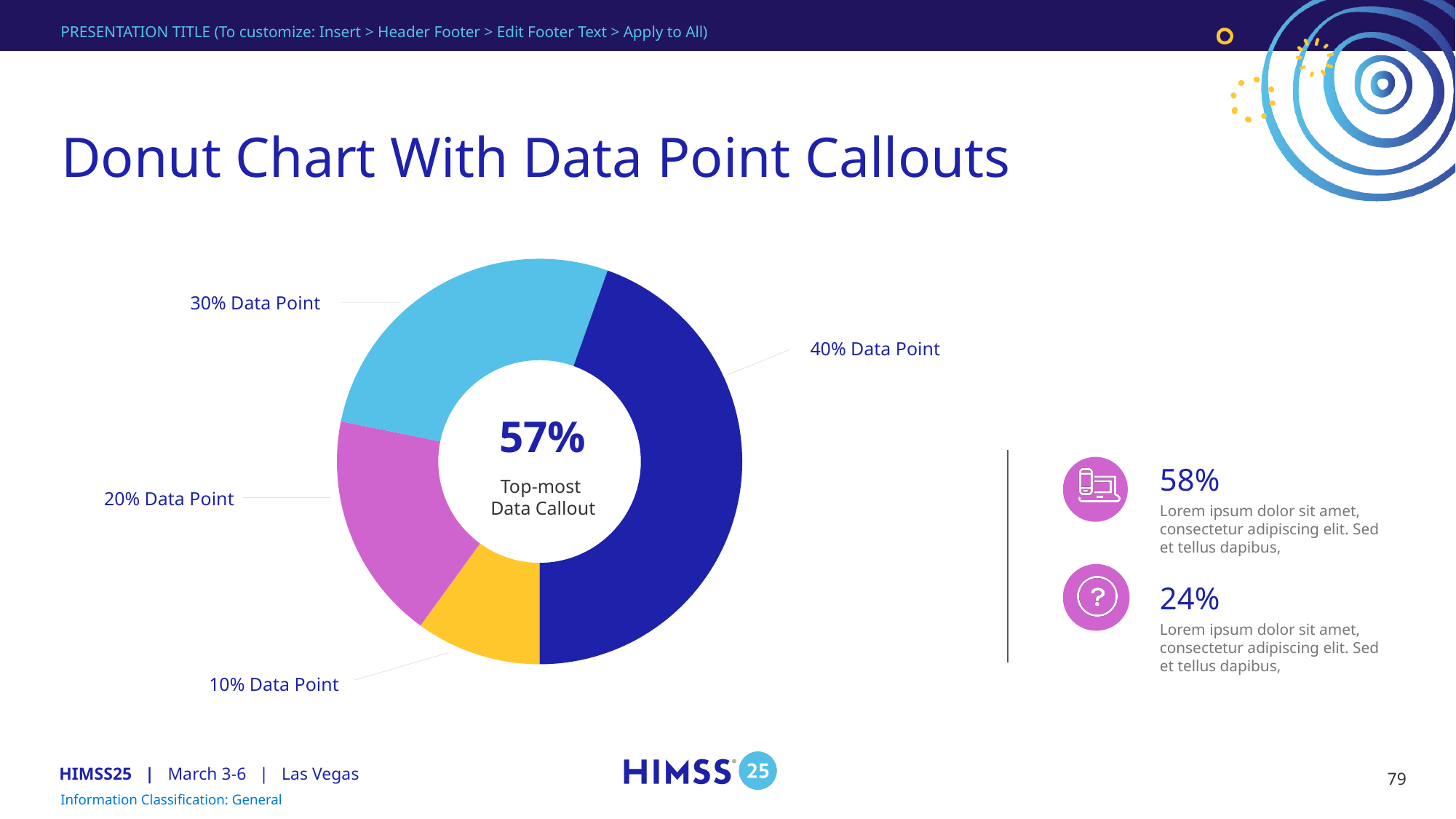
What is the difference between the largest and smallest slices of the donut chart? 30% What share of the donut does the dark blue slice represent? 40% What is the largest slice of the donut chart? 40% Data Point Which is larger, the light blue slice or the magenta slice? The light blue slice (30%) What share of the donut does the magenta slice represent? 20% What share of the donut does the yellow slice represent? 10% How many slices does the donut chart have? 4 What percentage is printed in the centre of the donut chart? 57% What is the smallest slice of the donut chart? 10% Data Point What is the title of the slide containing the donut chart? Donut Chart With Data Point Callouts What kind of chart is shown on the slide? Donut chart